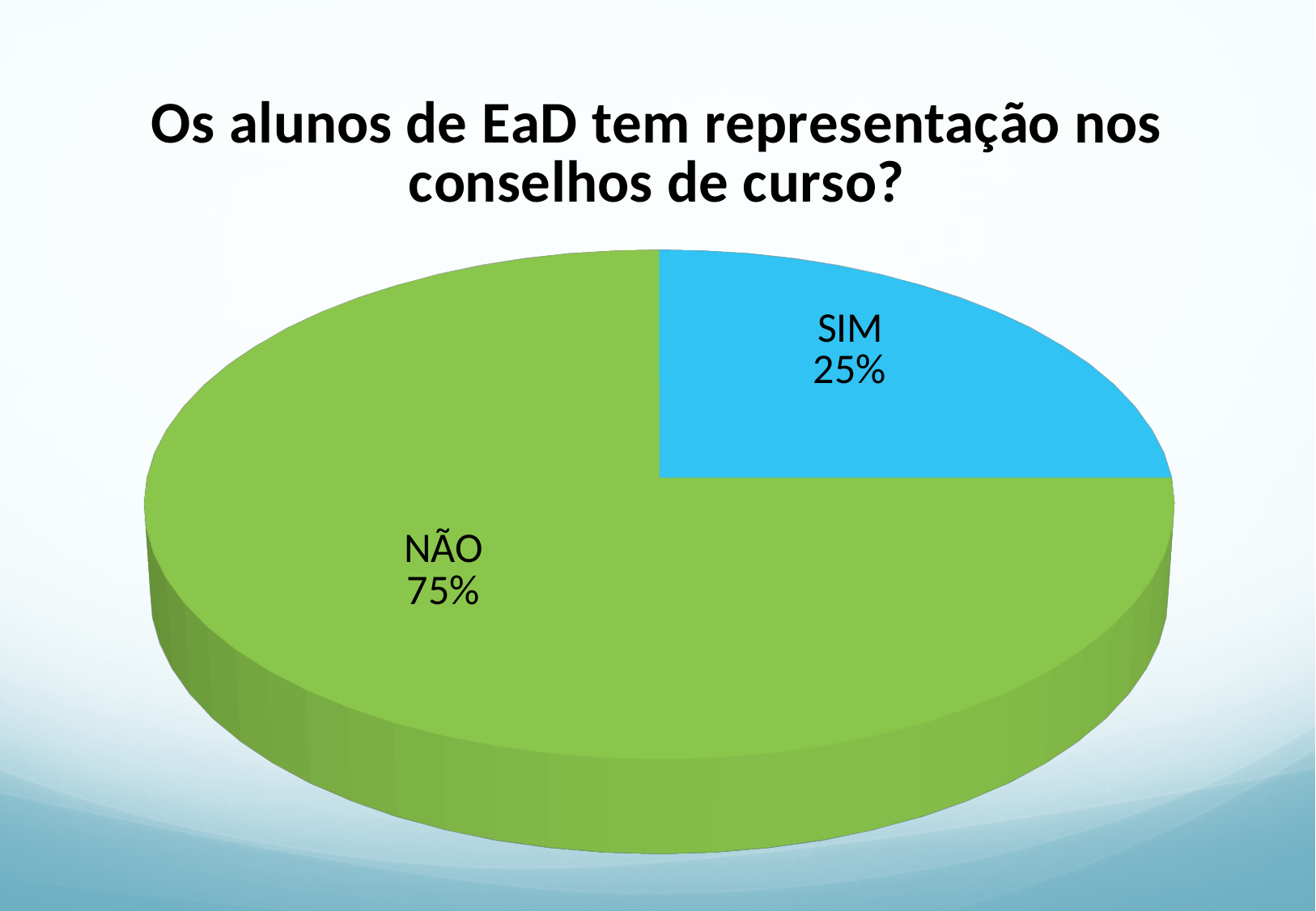
Which is larger, the share for SIM or the share for NÃO? NÃO What is the difference in percentage points between NÃO and SIM? 50 What is the title of the chart? Os alunos de EaD tem representação nos conselhos de curso? What percentage is shown for SIM? 25% What kind of chart is shown on the slide? pie chart How many slices does the pie chart have? 2 Which category has the smallest share of the pie? SIM What share of the pie does the SIM slice represent? 25% What percentage is shown for NÃO? 75% What colour is the NÃO slice? green Which category has the largest share of the pie? NÃO